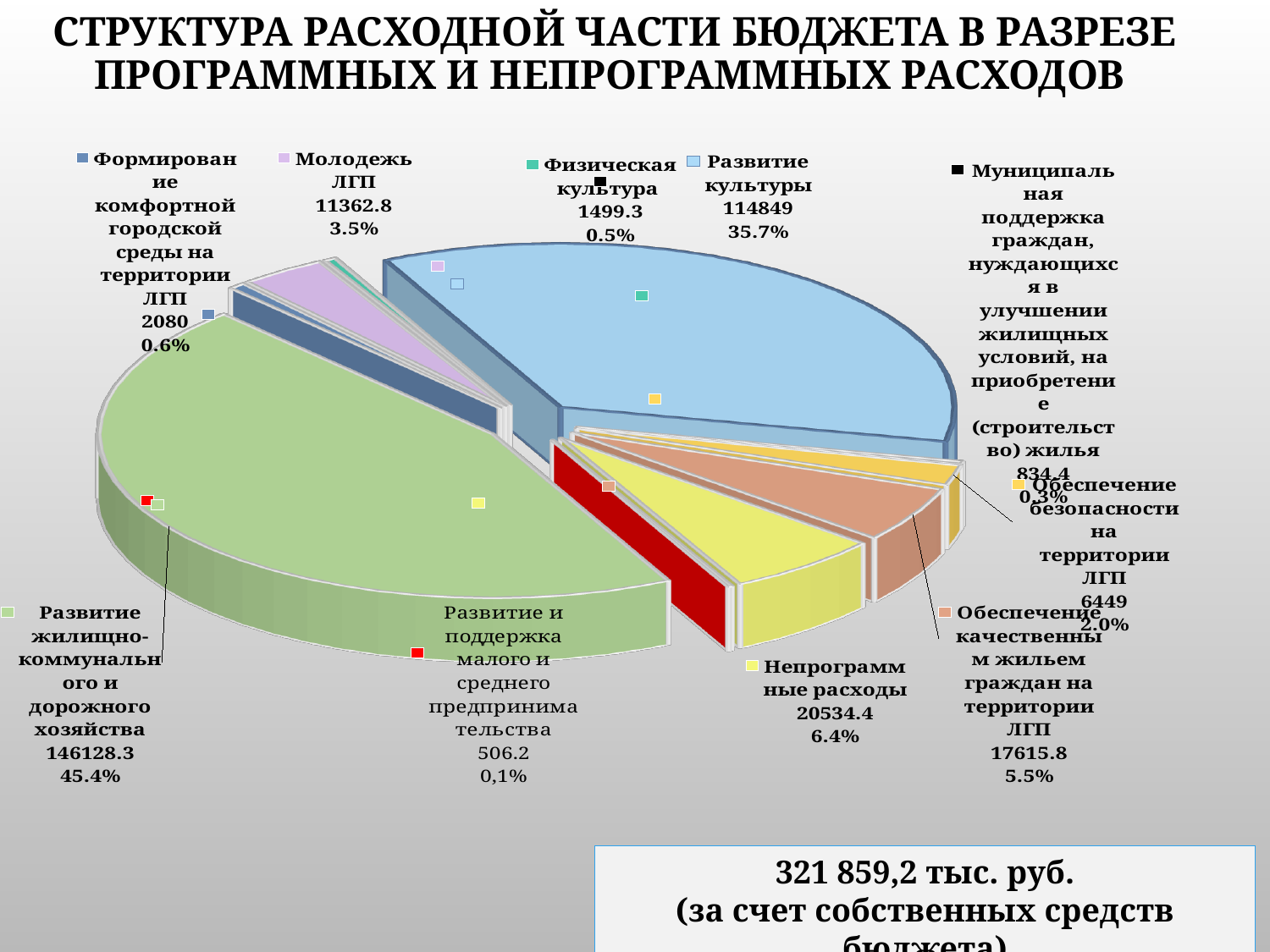
Which is larger: Непрограммные расходы or Обеспечение качественным жильем граждан на территории ЛГП? Непрограммные расходы What is the difference between the values for Развитие жилищно-коммунального и дорожного хозяйства and Развитие культуры? 31279.3 How many categories does the pie chart show? 10 What percentage is shown for Молодежь ЛГП? 3.5% What percentage is shown for Физическая культура? 0.5% What is the value shown for Развитие культуры? 114849 Which category has the smallest share of the pie? Развитие и поддержка малого и среднего предпринимательства What is the value shown for Обеспечение безопасности на территории ЛГП? 6449 What is the value shown for Непрограммные расходы? 20534.4 What share of the pie does Развитие жилищно-коммунального и дорожного хозяйства represent? 45.4% Which category has the largest share of the pie? Развитие жилищно-коммунального и дорожного хозяйства What kind of chart is shown on the slide? pie chart